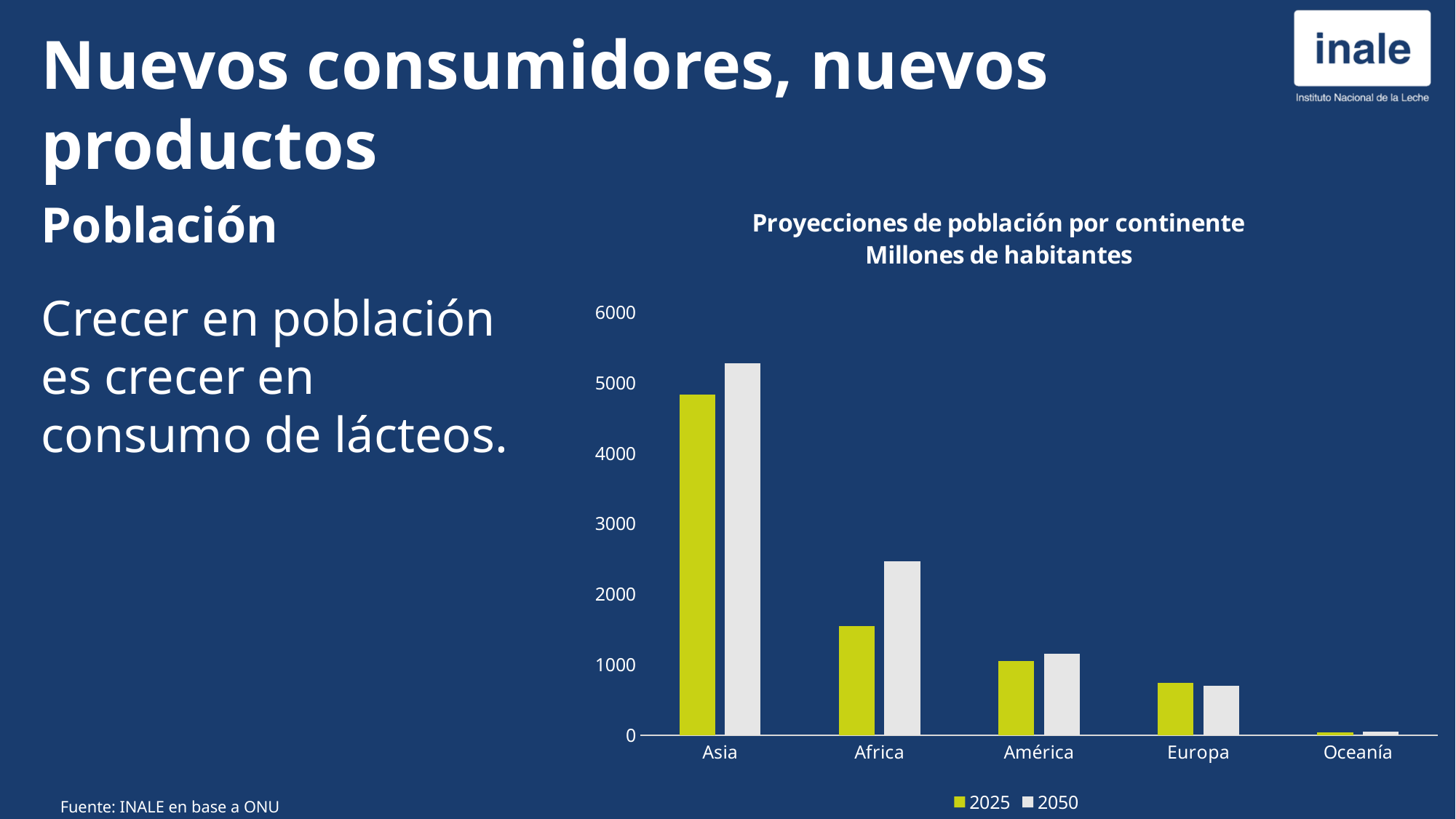
What is the title of the chart? Proyecciones de población por continente Millones de habitantes Which continent has the highest projected population for 2050? Asia How many series does the legend list? 2 Is the 2025 value for Europa greater or less than 1000? less Which continent has the lowest population for 2025? Oceanía How many continents are shown on the x axis? 5 Is the 2025 value for Asia greater or less than 5000? less What kind of chart is shown on the slide? bar chart Is the 2025 value for Africa greater or less than 2000? less For Africa, which is larger: the 2025 value or the 2050 value? 2050